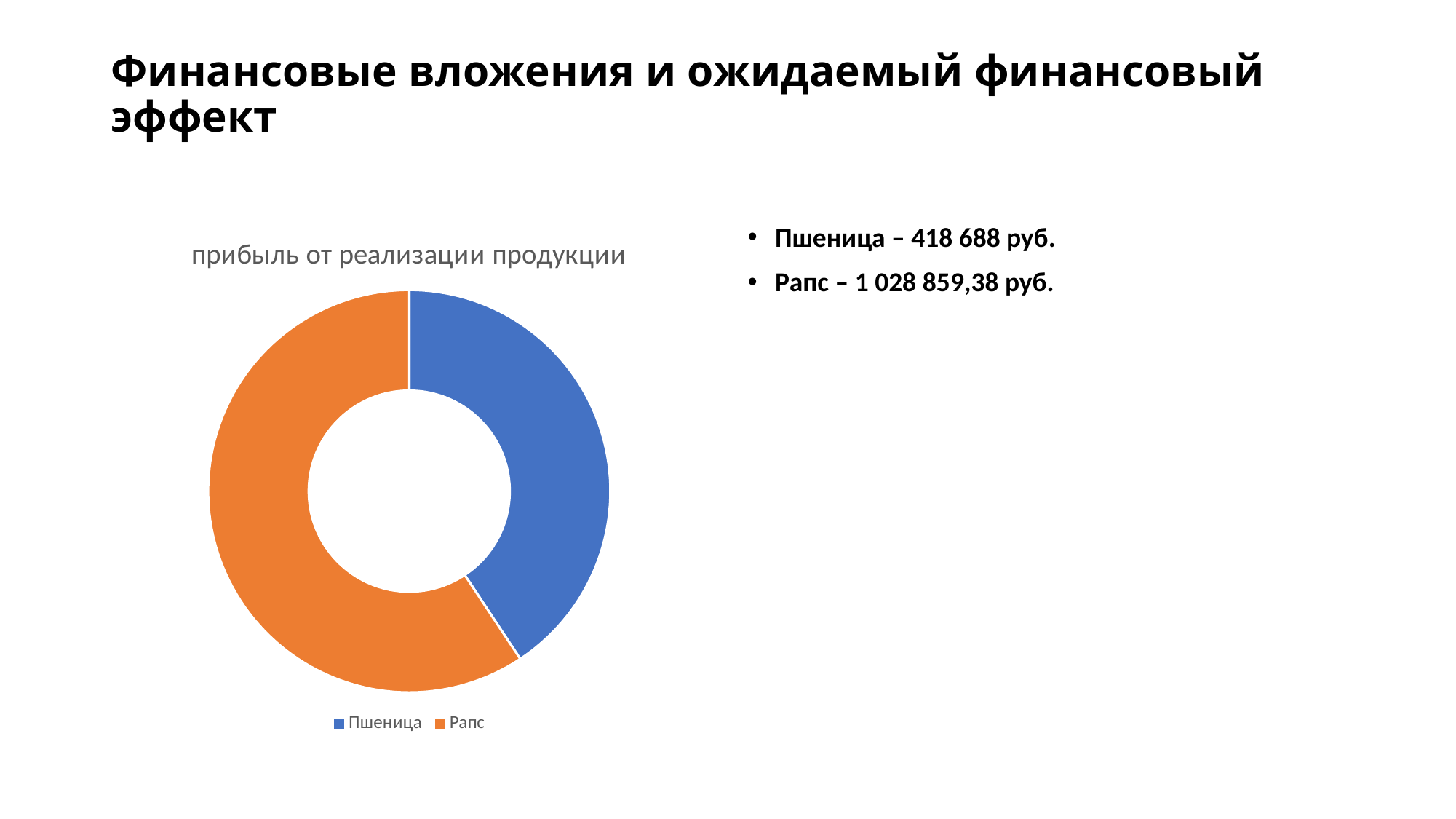
How many categories does the chart show? 2 What is the value for Пшеница stated on the slide? 418 688 руб. What colour represents Пшеница in the chart? Blue What kind of chart is shown on the slide? Doughnut (pie) chart What is the difference between the value for Рапс and the value for Пшеница? 610 171,38 руб. Which category has the smallest share of the chart? Пшеница What is the title of the chart? прибыль от реализации продукции What is the value for Рапс stated on the slide? 1 028 859,38 руб. Which is larger, the value for Пшеница or the value for Рапс? Рапс Which category has the largest share of the chart? Рапс How many entries does the chart legend list? 2